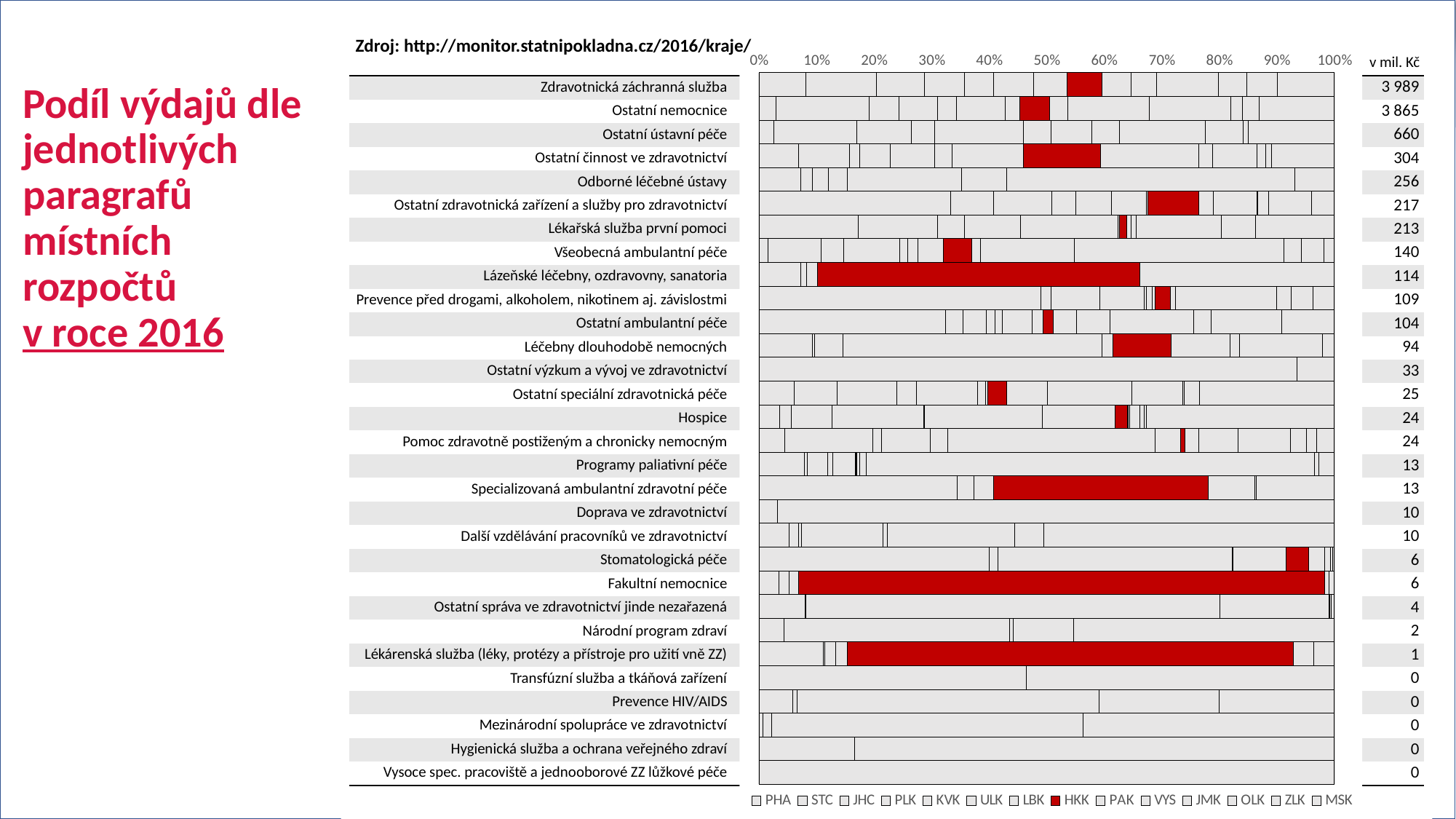
How many series does the legend list? 14 Which has a larger value in mil. Kč: Ostatní ústavní péče or Ostatní činnost ve zdravotnictví? Ostatní ústavní péče Is the HKK share for Zdravotnická záchranná služba greater or less than 10%? less Is the HKK share for Lázeňské léčebny, ozdravovny, sanatoria greater or less than 50%? greater What is the value in mil. Kč for Zdravotnická záchranná služba? 3 989 Which category has the highest value in mil. Kč? Zdravotnická záchranná služba What kind of chart is shown on the slide? Stacked bar chart Which legend series is highlighted in red in the chart? HKK What is the difference in mil. Kč between Zdravotnická záchranná služba and Ostatní nemocnice? 124 What is the value in mil. Kč for Lázeňské léčebny, ozdravovny, sanatoria? 114 How many categories (paragraphs) are plotted in the chart? 30